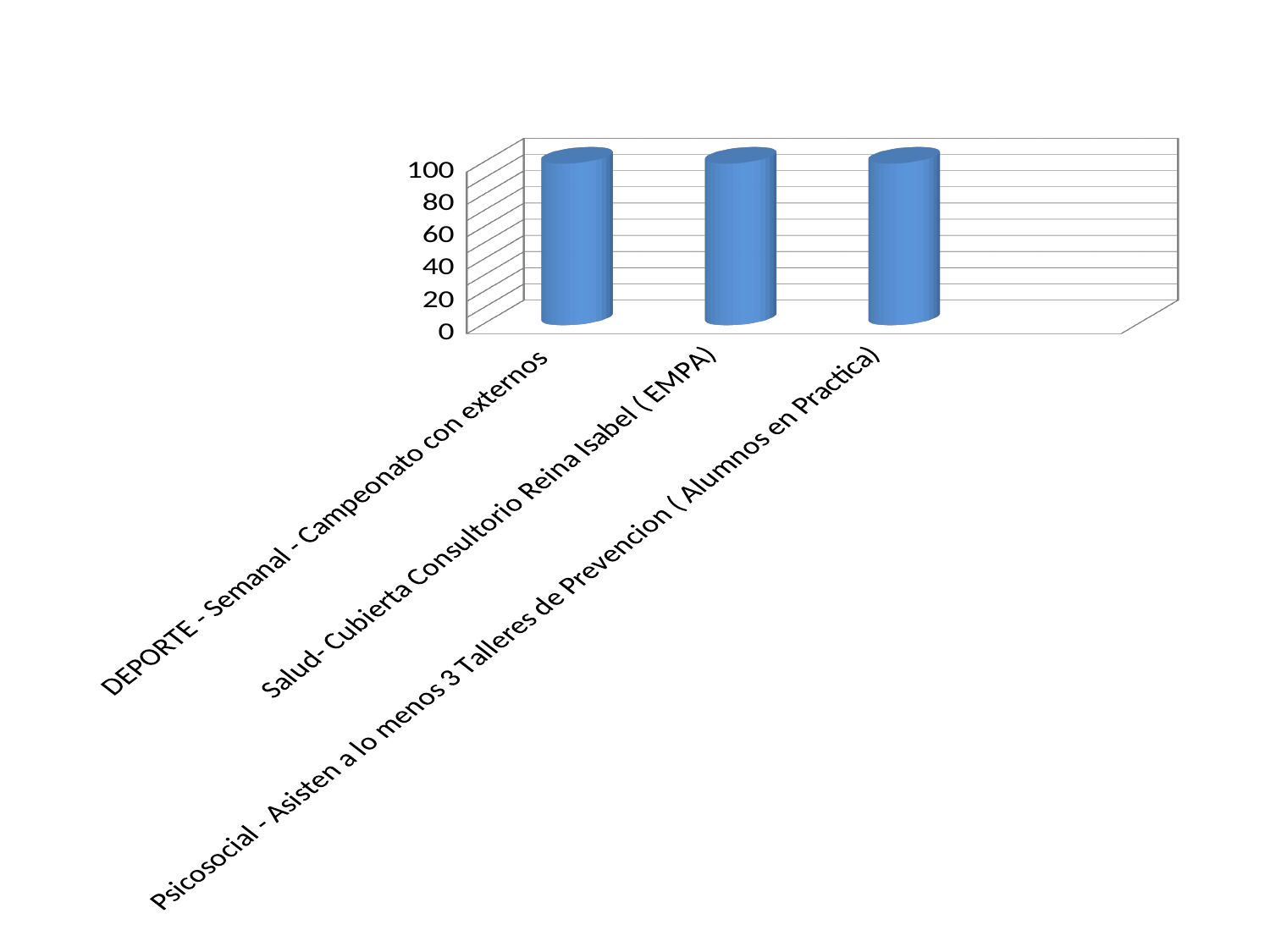
Do the values rise, fall, or stay the same across the categories from left to right? stay the same How many categories are plotted in the chart? 3 What is the value for "DEPORTE - Semanal - Campeonato con externos"? 100 What is the value for "Salud- Cubierta Consultorio Reina Isabel ( EMPA)"? 100 Is the value for "DEPORTE - Semanal - Campeonato con externos" greater or less than 80? greater Is the value for "Salud- Cubierta Consultorio Reina Isabel ( EMPA)" greater or less than 60? greater Is the value for "Psicosocial - Asisten a lo menos 3 Talleres de Prevencion ( Alumnos en Practica)" greater or less than 40? greater What colour are the bars in the chart? blue What kind of chart is shown on the slide? bar chart What is the highest value shown on the vertical axis? 100 What is the value for "Psicosocial - Asisten a lo menos 3 Talleres de Prevencion ( Alumnos en Practica)"? 100